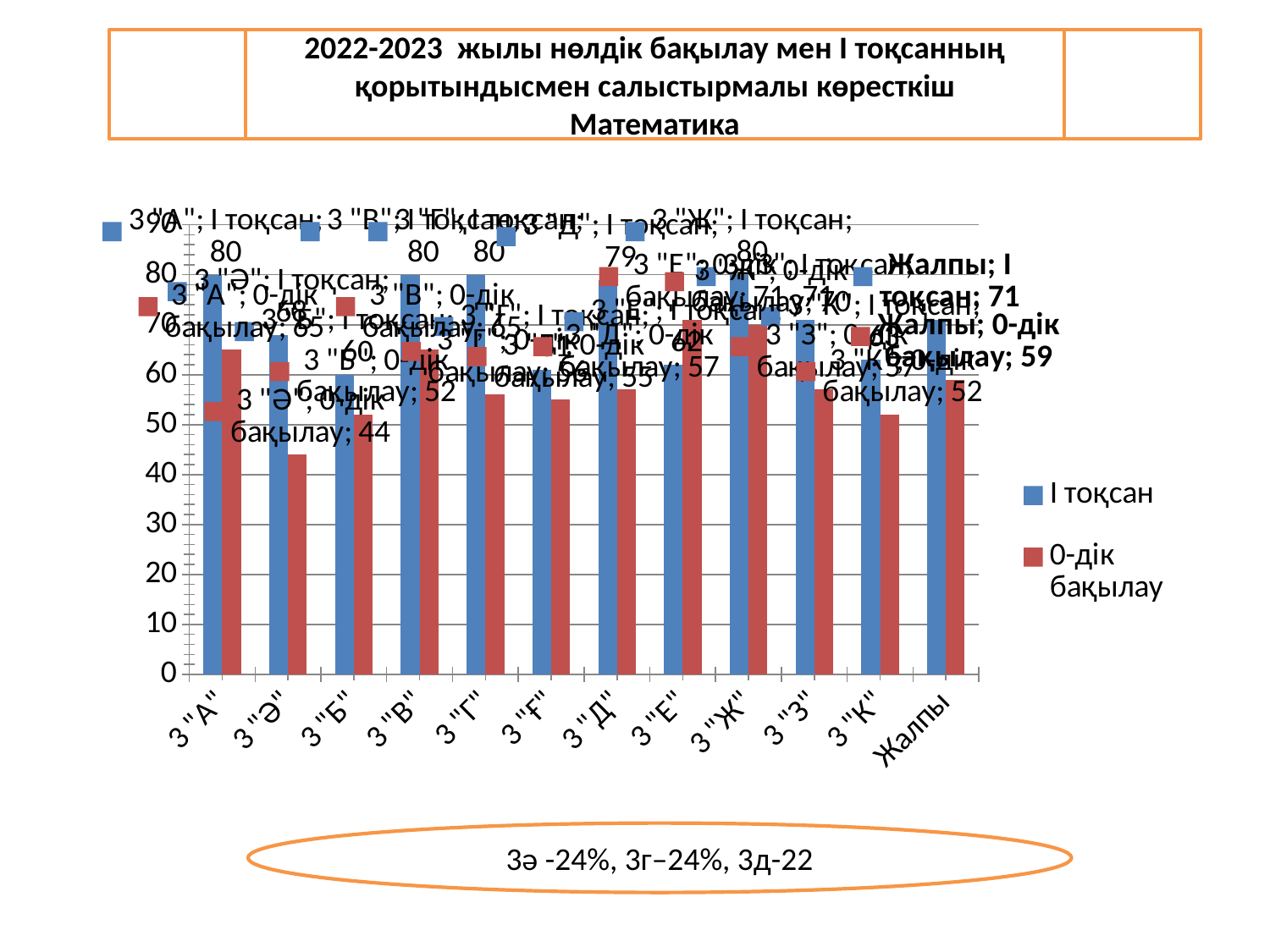
What is the difference between the І тоқсан and 0-дік бақылау values for Жалпы? 12 For 3 "Е", which series has the larger value, І тоқсан or 0-дік бақылау? 0-дік бақылау Which category has the lowest 0-дік бақылау value? 3 "Ә" What is the 0-дік бақылау value for Жалпы? 59 What is the І тоқсан value for 3 "Д"? 79 Is the І тоқсан value for 3 "Ә" greater or less than 60? greater What kind of chart is shown on the slide? bar chart What is the І тоқсан value for Жалпы? 71 How many series does the legend list? 2 What is the 0-дік бақылау value for 3 "Ә"? 44 What is the 0-дік бақылау value for 3 "К"? 52 How many categories are shown on the x axis? 12